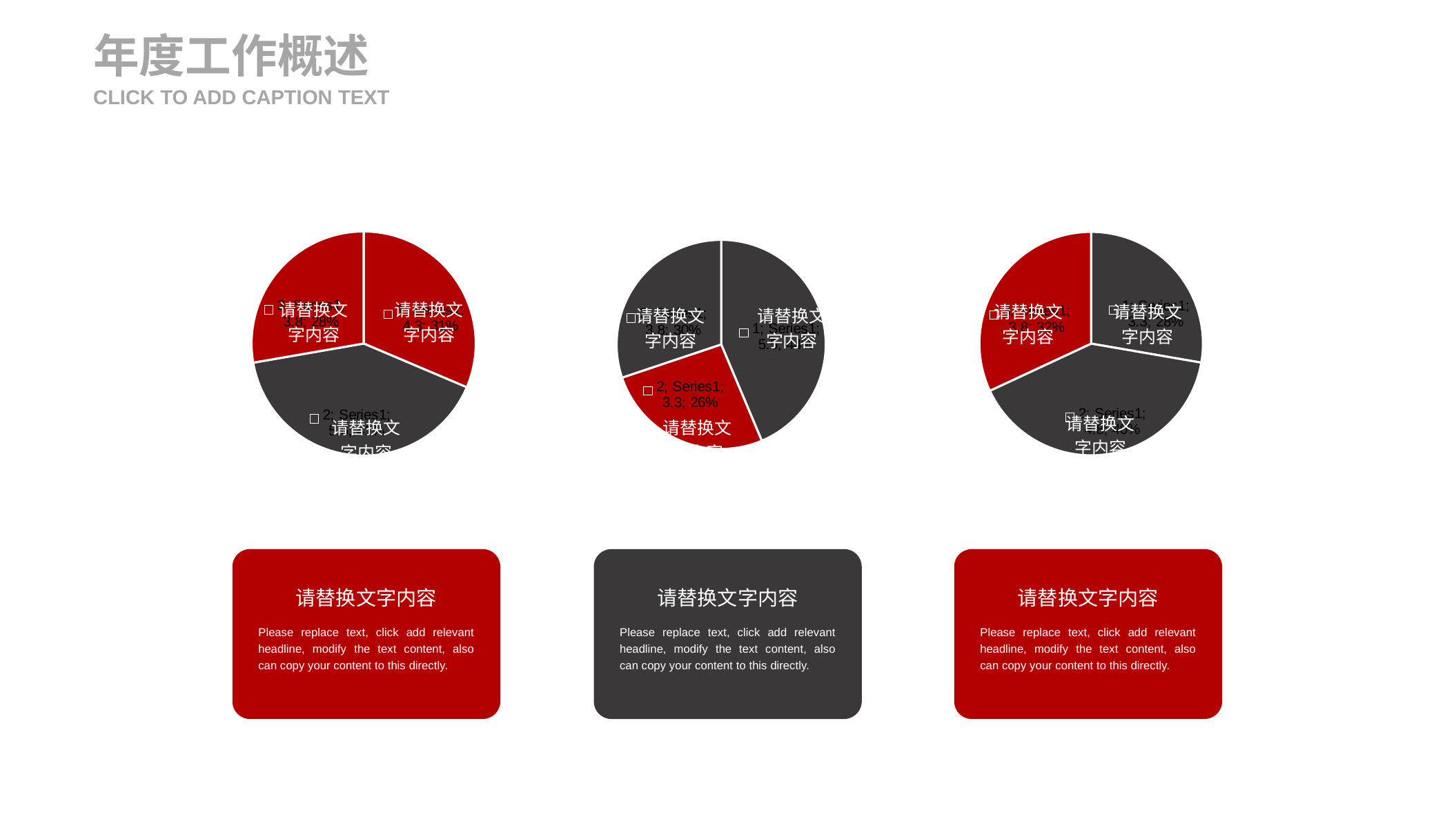
What kind of chart is shown in the middle of the slide? pie chart How many pie charts are on the slide? 3 In the right pie chart, is the red slice larger or smaller than the bottom dark grey slice? smaller In the left pie chart, which slice is the largest: the dark grey slice or either red slice? the dark grey slice In the middle pie chart, what value is printed for the red slice labelled 2? 3.3 How many slices does the middle pie chart have? 3 How many slices does the left pie chart have? 3 In the middle pie chart, what share of the pie is the red slice labelled 2? 26% In the middle pie chart, which slice is the largest: the red slice, the upper-left dark slice, or the right dark slice? the right dark slice What series name is printed in the slice labels of the middle pie chart? Series1 In the middle pie chart, which slice is the smallest? the red slice labelled 2